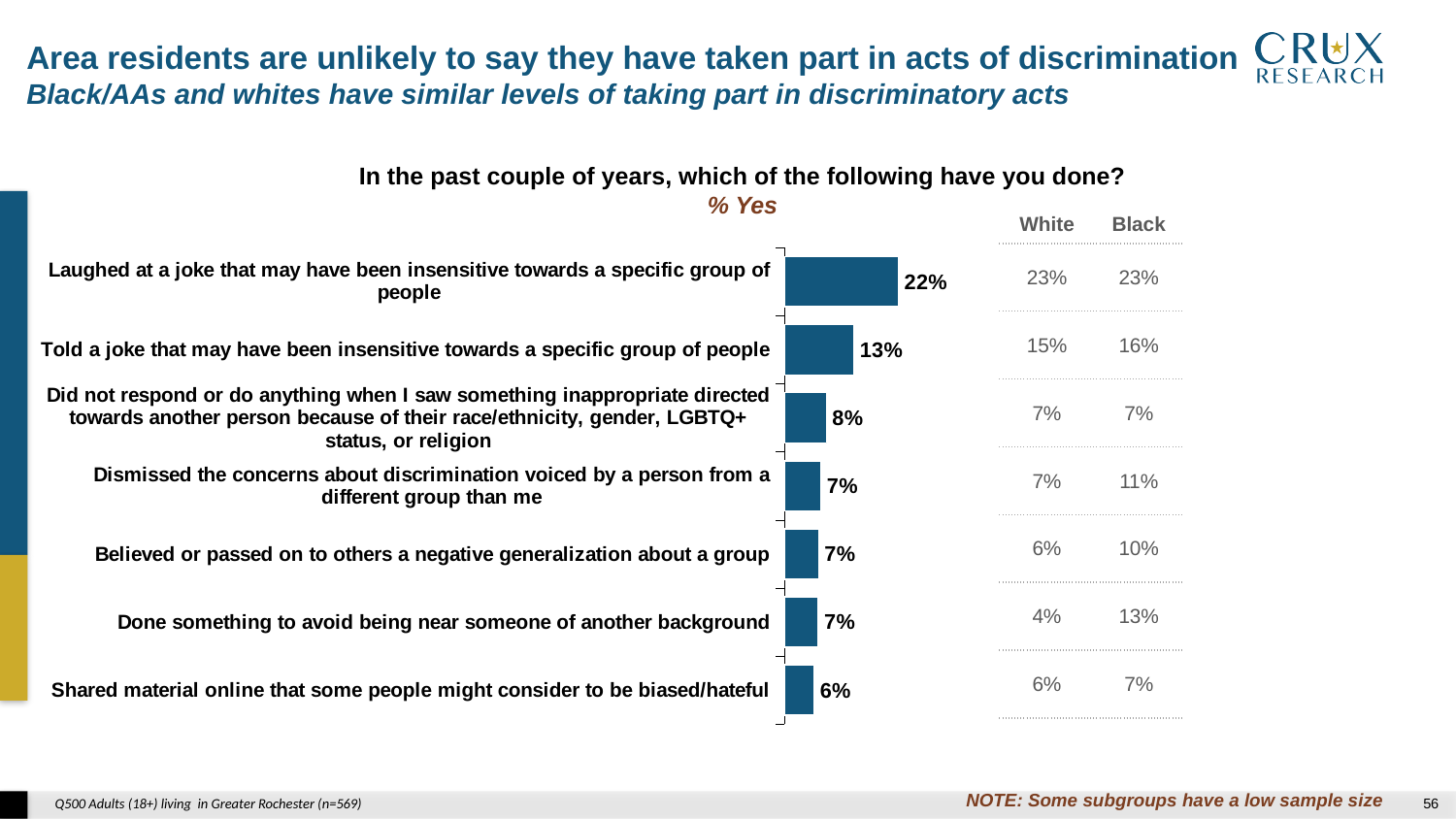
Which item has the lowest % Yes in the bar chart? Shared material online that some people might consider to be biased/hateful How many items (bars) are shown in the bar chart? 7 What percentage of respondents said they shared material online that some people might consider to be biased/hateful? 6% What is the % Yes for 'Did not respond or do anything when I saw something inappropriate directed towards another person because of their race/ethnicity, gender, LGBTQ+ status, or religion'? 8% What is the % Yes for 'Done something to avoid being near someone of another background'? 7% What percentage of respondents said they laughed at a joke that may have been insensitive towards a specific group of people? 22% What percentage of respondents said they told a joke that may have been insensitive towards a specific group of people? 13% Which item has the highest % Yes in the bar chart? Laughed at a joke that may have been insensitive towards a specific group of people What is the difference in % Yes between laughing at an insensitive joke and telling an insensitive joke? 9% Which has a higher % Yes: telling an insensitive joke or dismissing the concerns about discrimination voiced by a person from a different group? Told a joke that may have been insensitive towards a specific group of people What type of chart is used on this slide? Bar chart What is the question text shown as the chart's title? In the past couple of years, which of the following have you done?